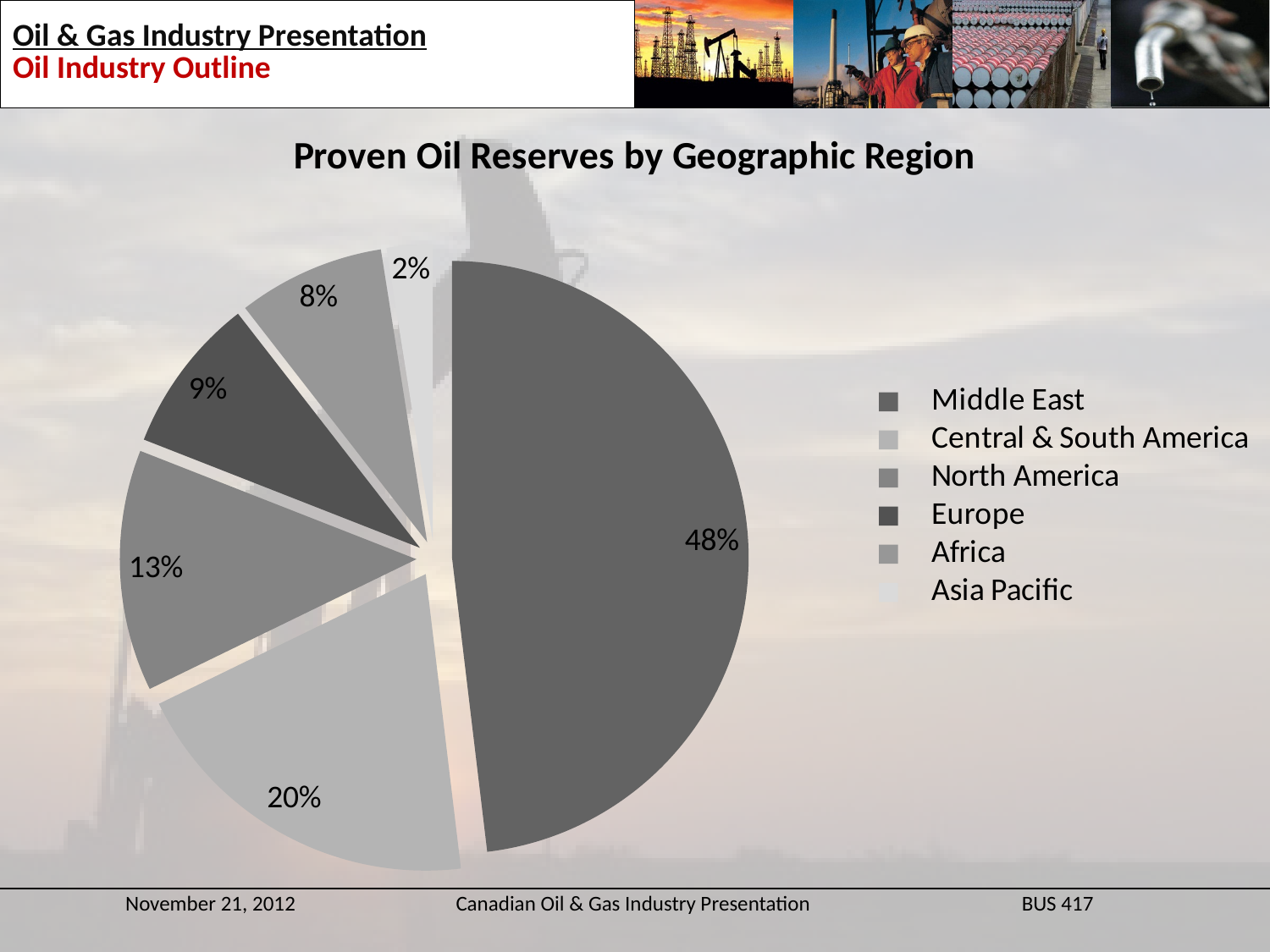
Which has a larger share of proven oil reserves, Europe or Africa? Europe What share of proven oil reserves does Central & South America hold? 20% What share of proven oil reserves does Asia Pacific hold? 2% What share of proven oil reserves does North America hold? 13% Which region has the largest share of proven oil reserves? Middle East What kind of chart is shown on the slide? Pie chart Which region has the smallest share of proven oil reserves? Asia Pacific What share of proven oil reserves does Europe hold? 9% What is the title of the chart? Proven Oil Reserves by Geographic Region How many percentage points larger is the Middle East's share than Central & South America's share? 28 What share of proven oil reserves does the Middle East hold? 48% How many regions does the legend list? 6